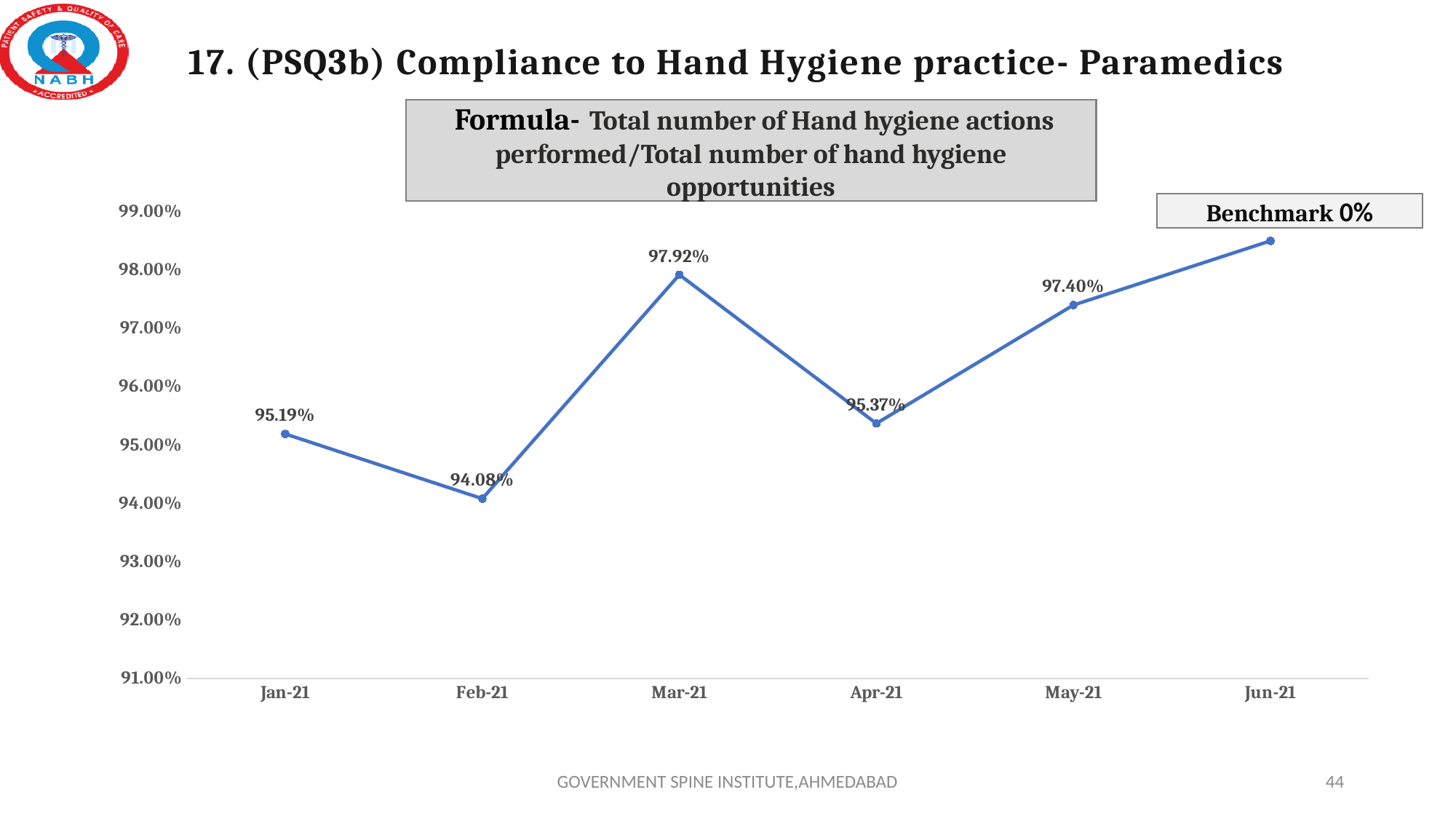
What is the value plotted for Mar-21? 97.92% What is the value plotted for Feb-21? 94.08% What is the value plotted for May-21? 97.40% What is the value plotted for Apr-21? 95.37% Which is larger, the value for Apr-21 or the value for Jan-21? Apr-21 How many months are plotted on the chart? 6 What is the hand hygiene compliance value for Jan-21? 95.19% What is the difference between the Mar-21 and Feb-21 values? 3.84% Which month has the highest compliance value? Jun-21 Which month has the lowest compliance value? Feb-21 Is the value for Jun-21 greater or less than 98.00%? greater What kind of chart is shown on the slide? line chart